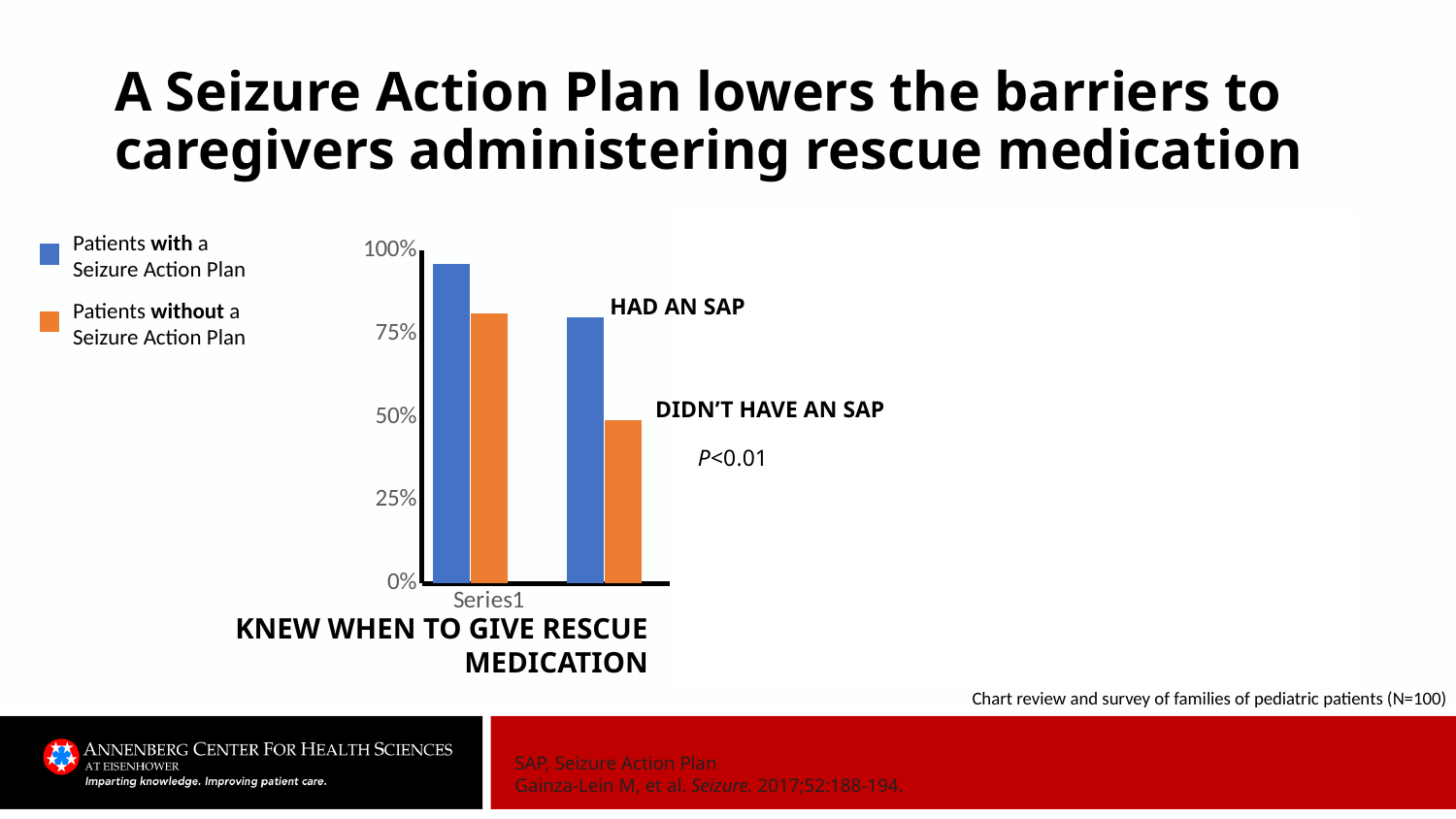
Is the value of the orange bar in the left group of bars greater or less than 50%? greater How many series does the legend list? 2 Which bar in the chart is the tallest? the blue bar in the left group What P value is shown next to the chart? P<0.01 Is the value of the blue bar in the right group of bars greater or less than 50%? greater Is the value of the orange bar in the right group of bars greater or less than 75%? less How many groups of bars are plotted in the chart? 2 What kind of chart is shown on the slide? bar chart Which colour represents patients with a Seizure Action Plan in the chart? blue Which bar in the chart is the shortest? the orange bar in the right group In the right group of bars, which is larger: the blue bar (patients with a Seizure Action Plan) or the orange bar (patients without)? the blue bar